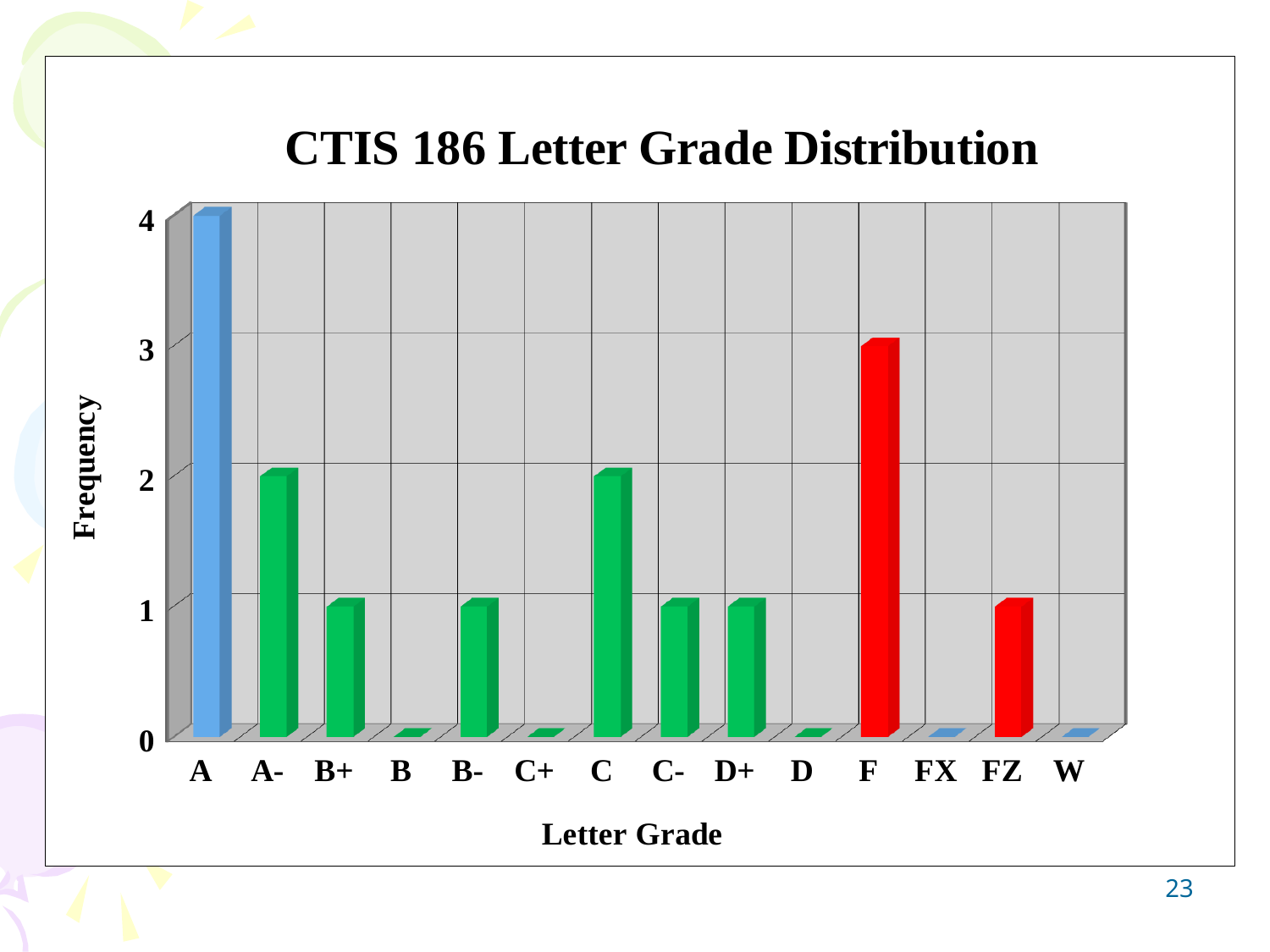
How many letter grade categories are shown on the x axis? 14 What is the frequency for letter grade F? 3 What kind of chart is shown on the slide? Bar chart What is the frequency for letter grade C? 2 What is the frequency for letter grade A? 4 Which has a higher frequency, grade A- or grade D+? A- Which letter grade has the highest frequency? A Which has a higher frequency, grade F or grade C? F What is the difference in frequency between grade A- and grade B+? 1 What is the title of the chart? CTIS 186 Letter Grade Distribution What is the difference in frequency between grade A and grade F? 1 What is the frequency for letter grade FZ? 1